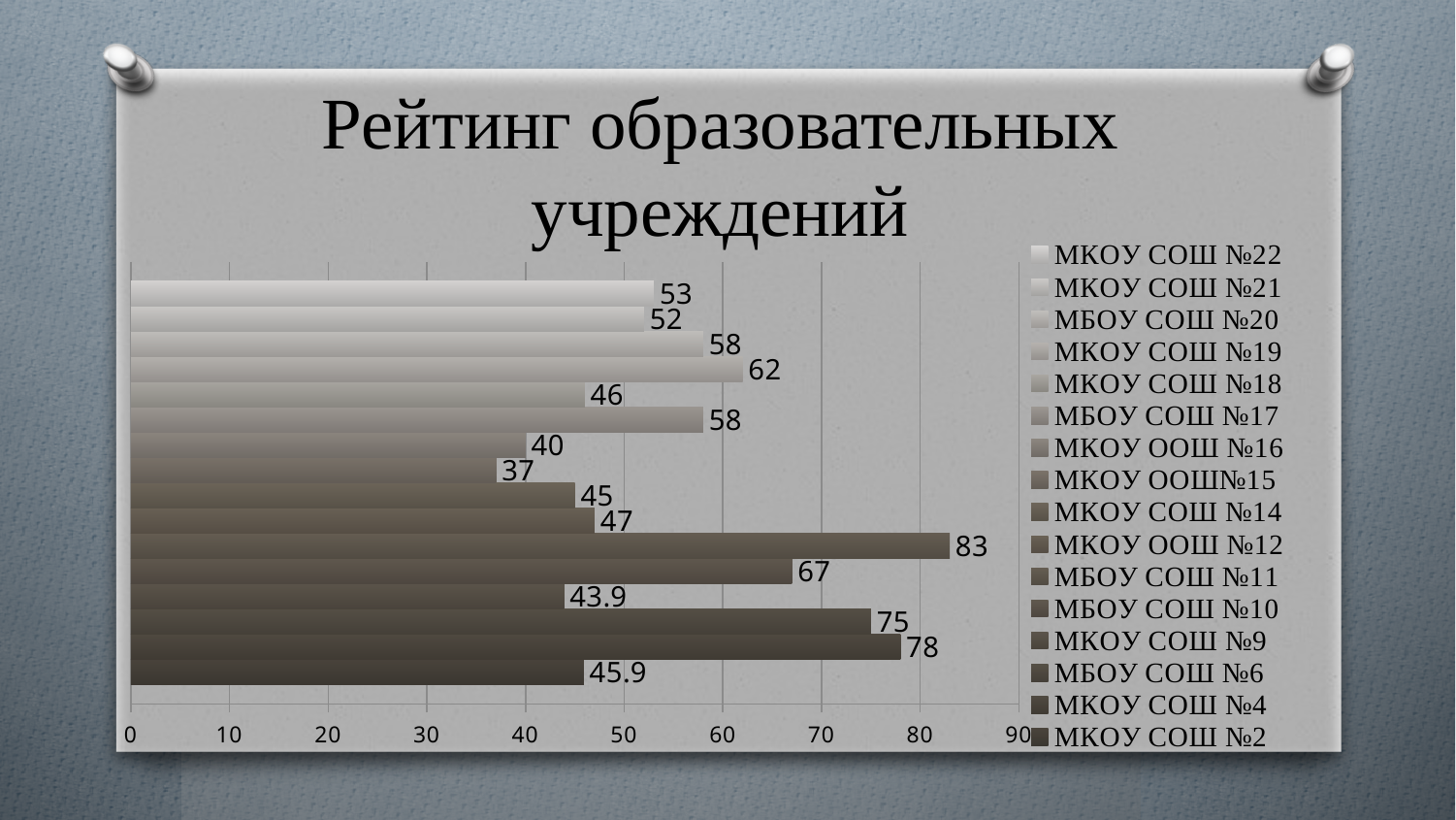
What is the value of the bottom bar in the chart? 45.9 How many bars have a value greater than 70? 3 Is the longest bar in the chart greater or less than 80? greater Which entry appears at the top of the legend? МКОУ СОШ №22 What is the title of the chart on the slide? Рейтинг образовательных учреждений What kind of chart is shown on the slide? bar chart How many entries does the legend list? 16 What is the difference between the highest bar value (83) and the lowest bar value (37)? 46 How many bars are plotted in the chart? 16 What is the lowest value shown on any bar in the chart? 37 What is the highest value shown on any bar in the chart? 83 What is the value of the topmost bar in the chart? 53